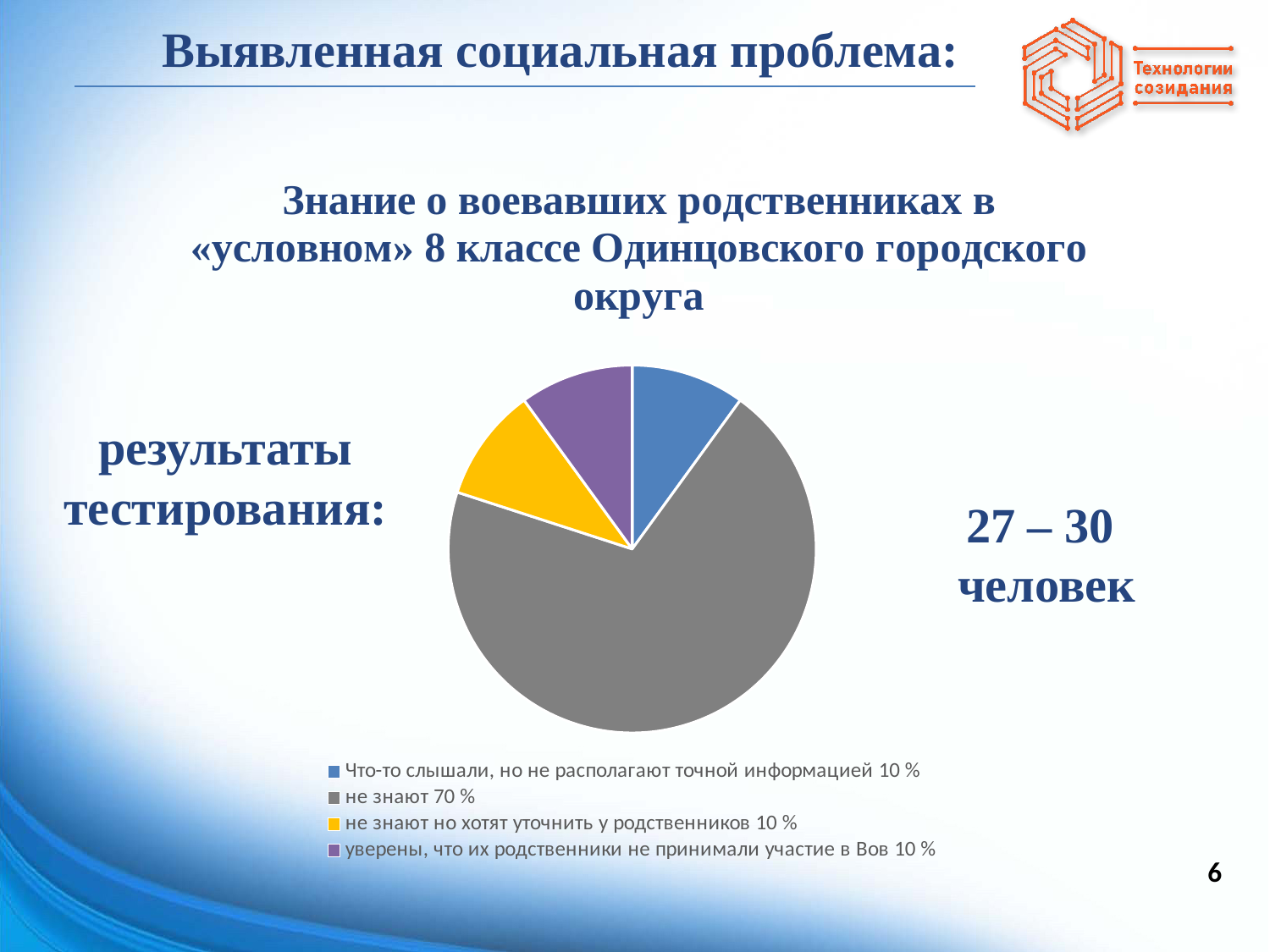
What percentage of the pie corresponds to "не знают"? 70 % What percentage is shown for "уверены, что их родственники не принимали участие в Вов"? 10 % What colour is the "не знают" slice in the pie chart? grey Which category has the largest slice of the pie? не знают What is the difference in percentage points between "не знают" and "не знают но хотят уточнить у родственников"? 60 % What share of the pie does the "не знают" slice take? 70 % Which is larger: the slice for "не знают" or the slice for "Что-то слышали, но не располагают точной информацией"? не знают What percentage is shown for "Что-то слышали, но не располагают точной информацией"? 10 % How many slices does the pie chart have? 4 What percentage is shown for "не знают но хотят уточнить у родственников"? 10 % What colour is the slice for "не знают но хотят уточнить у родственников"? yellow What kind of chart is shown on the slide? pie chart